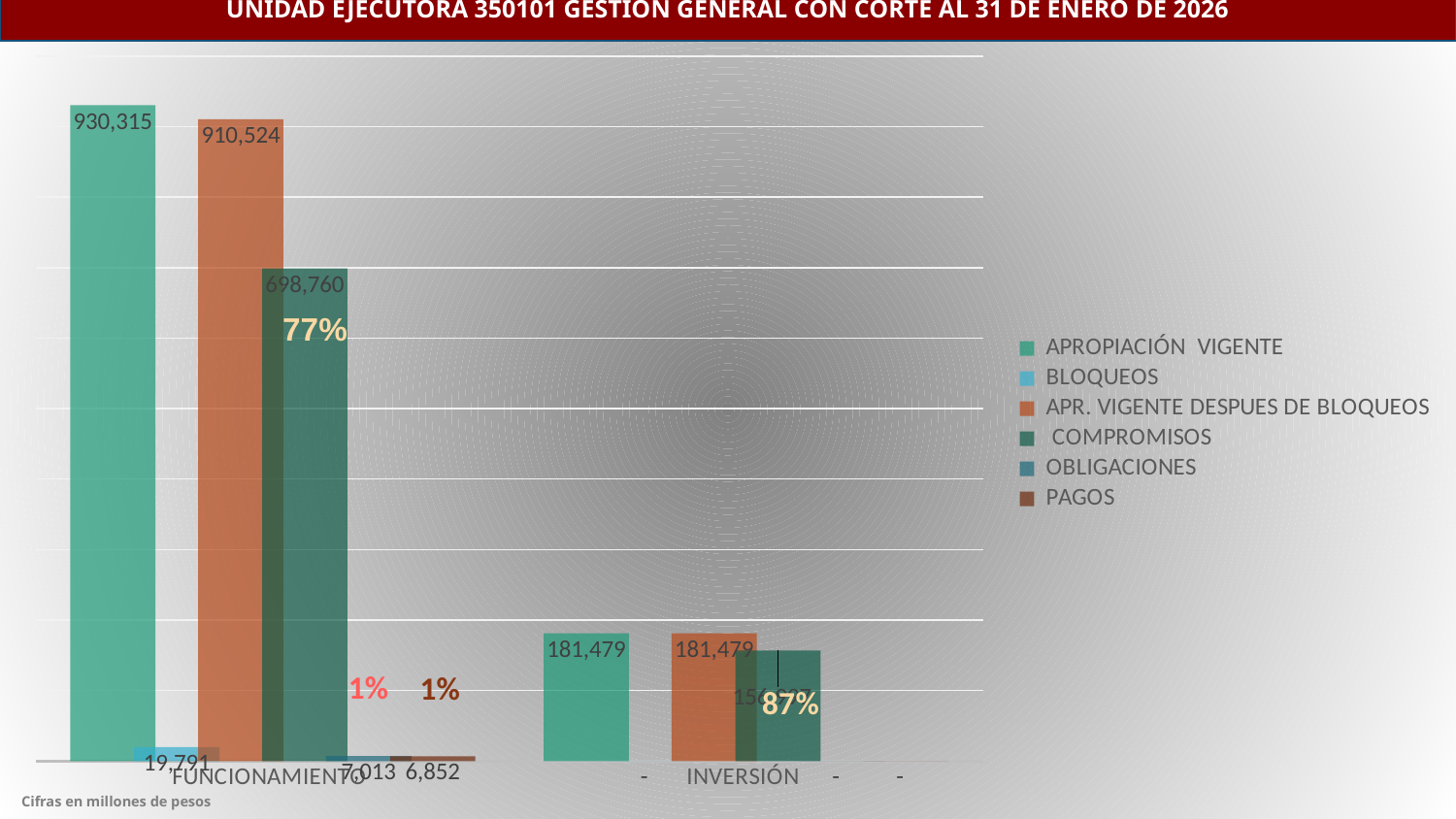
What kind of chart is shown on the slide? Bar chart What is the value of APROPIACIÓN VIGENTE for FUNCIONAMIENTO? 930,315 Which is larger for FUNCIONAMIENTO: OBLIGACIONES or PAGOS? OBLIGACIONES How many series does the legend list? 6 What is the difference between APROPIACIÓN VIGENTE and APR. VIGENTE DESPUES DE BLOQUEOS for FUNCIONAMIENTO? 19,791 How many categories are shown on the x axis? 2 What is the value of APR. VIGENTE DESPUES DE BLOQUEOS for FUNCIONAMIENTO? 910,524 What is the value of APROPIACIÓN VIGENTE for INVERSIÓN? 181,479 Which series has the highest value for FUNCIONAMIENTO? APROPIACIÓN VIGENTE What is the value of BLOQUEOS for FUNCIONAMIENTO? 19,791 What percentage label is shown on the COMPROMISOS bar for INVERSIÓN? 87% What is the value of COMPROMISOS for FUNCIONAMIENTO? 698,760